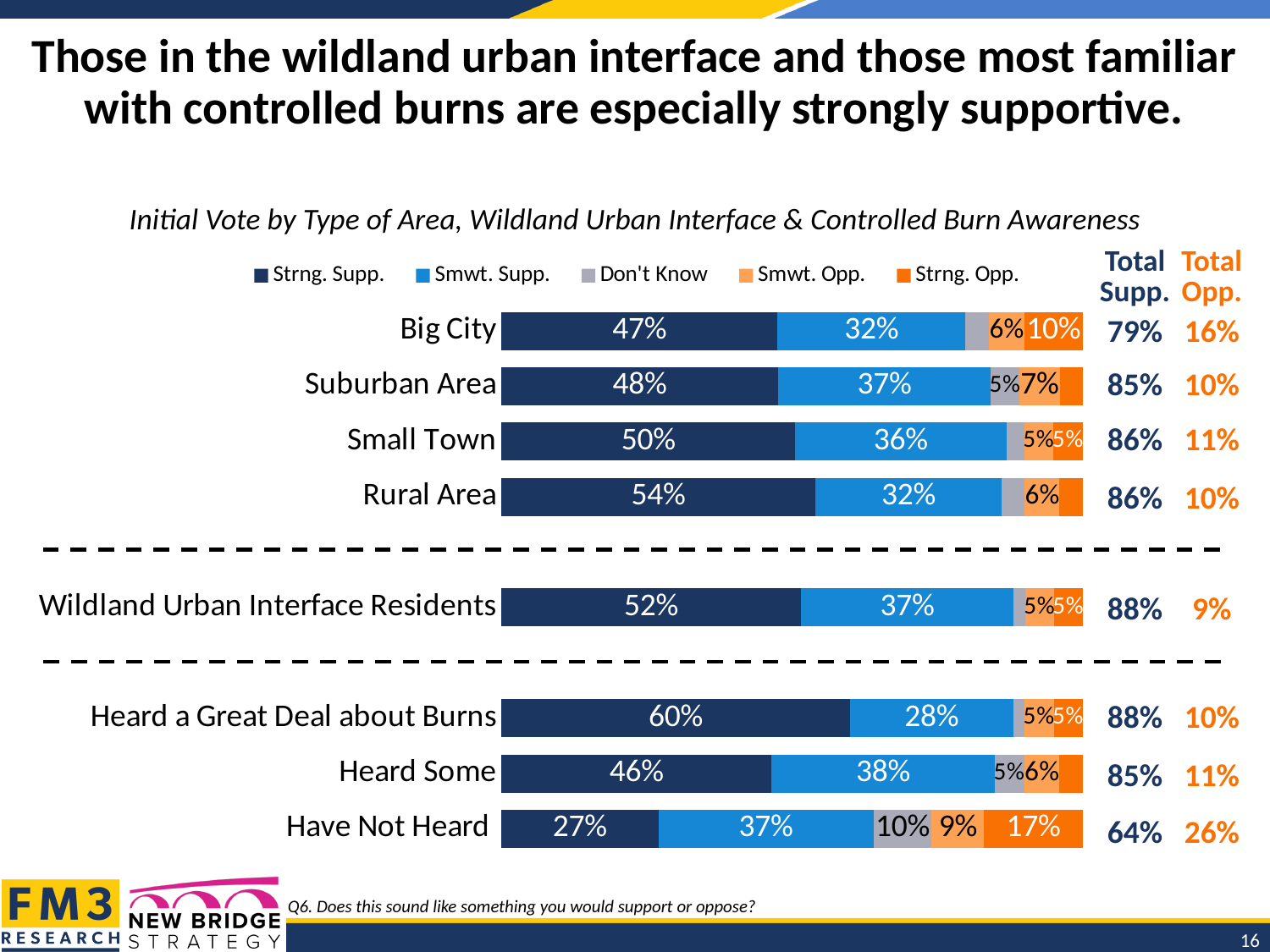
How many categories (bars) are plotted in the chart? 8 What is the Total Supp. figure shown for Wildland Urban Interface Residents? 88% Which has a larger Smwt. Supp. value, Suburban Area or Big City? Suburban Area What is the difference between the Strng. Supp. value for Heard a Great Deal about Burns and for Have Not Heard? 33 percentage points Which category has the highest Strng. Supp. value? Heard a Great Deal about Burns What is the subtitle of the chart? Initial Vote by Type of Area, Wildland Urban Interface & Controlled Burn Awareness What is the Strng. Opp. value for Have Not Heard? 17% Which category has the lowest Strng. Supp. value? Have Not Heard How many series does the legend list? 5 What kind of chart is shown on the slide? Stacked bar chart What is the Strng. Supp. value for Rural Area? 54% What is the Smwt. Supp. value for Heard Some? 38%